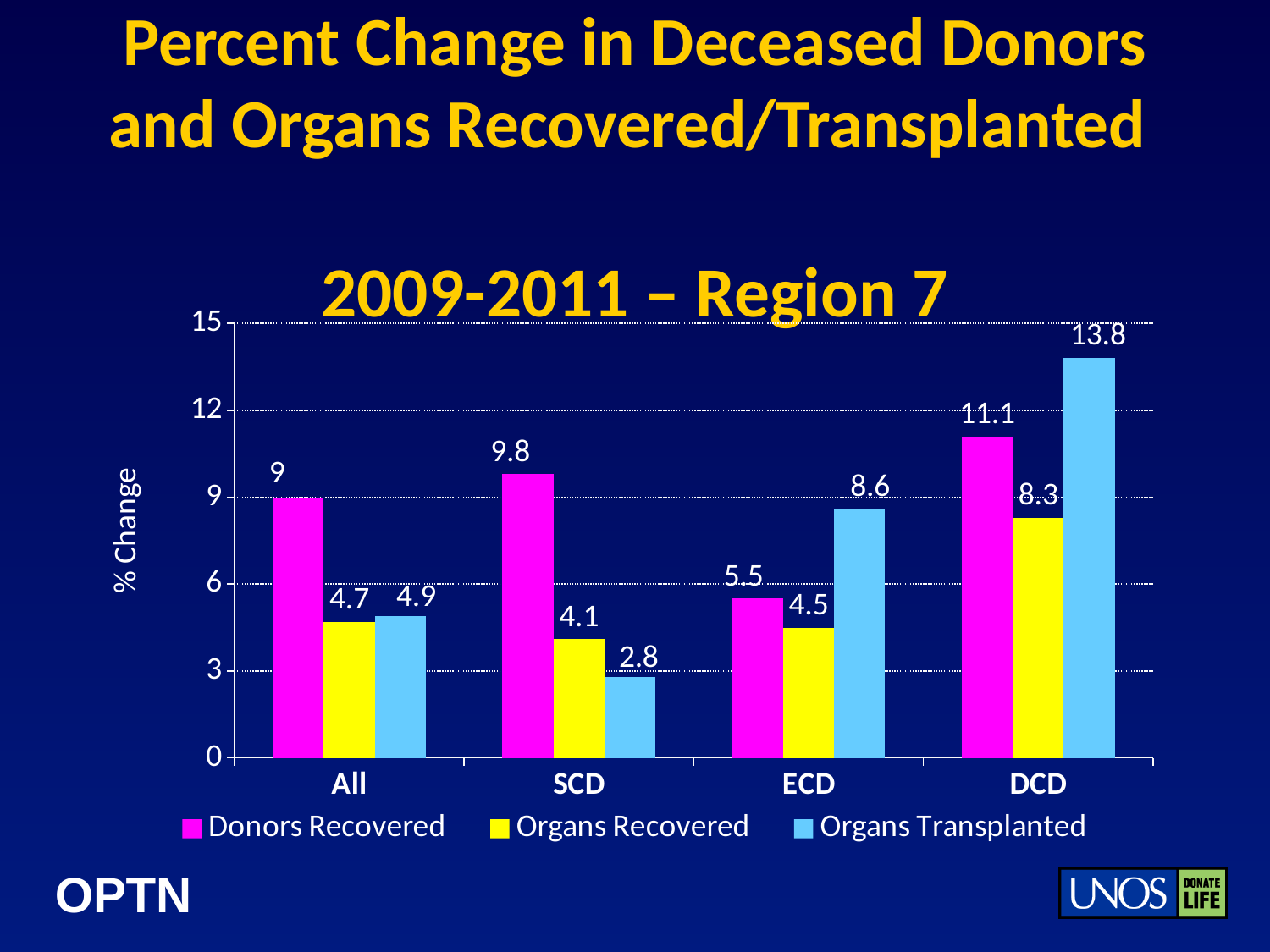
How many donor categories are shown on the x axis? 4 What is the percent change in Organs Recovered for SCD? 4.1 What is the percent change in Donors Recovered for the All category? 9 Which category has the highest Organs Transplanted value? DCD Which category has the lowest Organs Transplanted value? SCD What type of chart is shown? Bar chart What is the chart's subtitle above the plot area? 2009-2011 – Region 7 Is the Donors Recovered value for DCD greater or less than 9? greater Which is larger for ECD: Donors Recovered or Organs Transplanted? Organs Transplanted What is the difference between Donors Recovered and Organs Transplanted for SCD? 7 What is the percent change in Organs Transplanted for DCD? 13.8 How many series does the legend list? 3